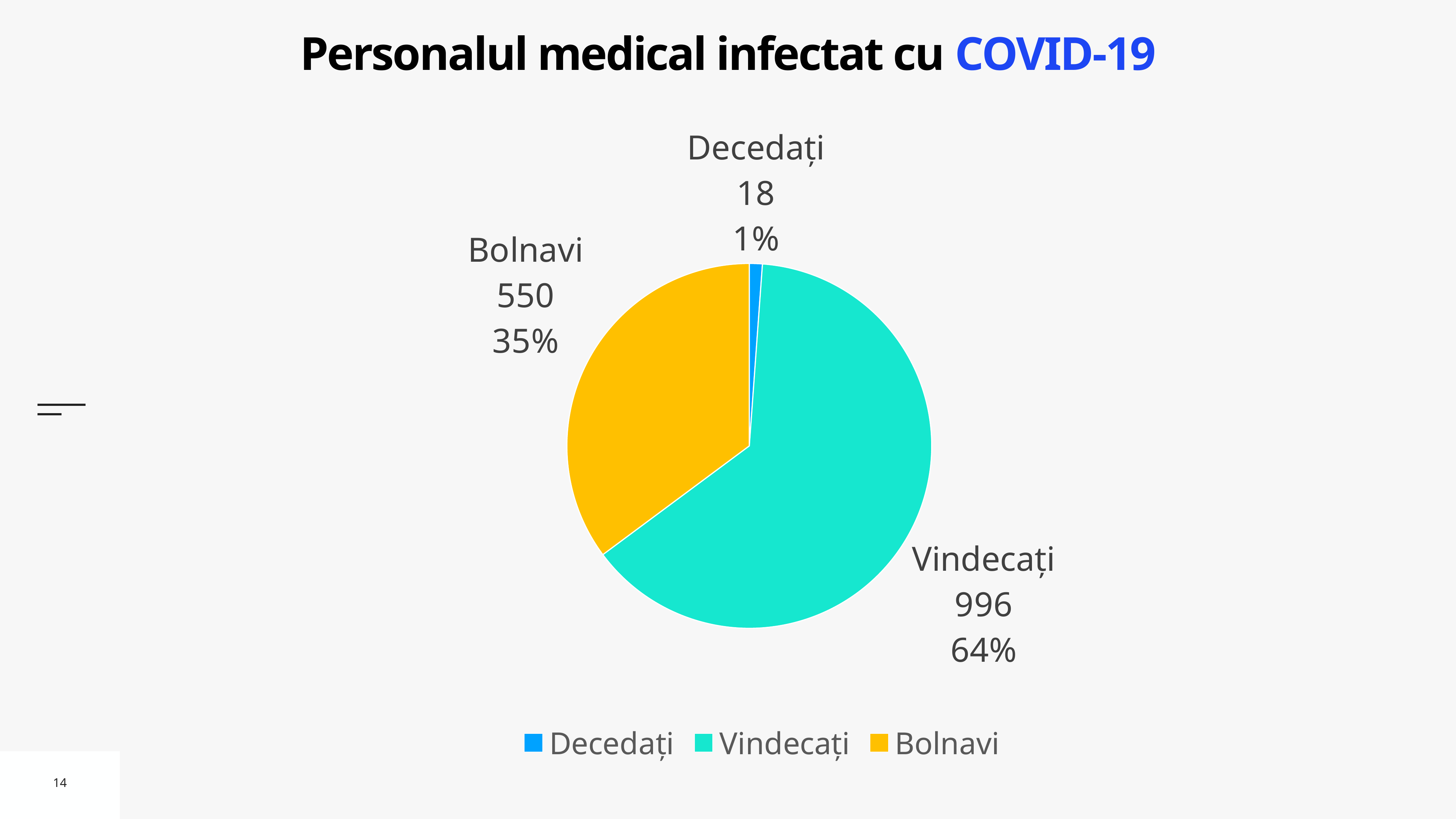
Which category has the smallest slice? Decedați What share of the pie does Bolnavi represent? 35% How many categories does the pie chart have? 3 What is the title of the slide? Personalul medical infectat cu COVID-19 Which is larger, the value for Bolnavi or the value for Decedați? Bolnavi Which category has the largest slice? Vindecați What is the difference between the values for Vindecați and Bolnavi? 446 What is the value for Vindecați? 996 What is the value for Bolnavi? 550 What share of the pie does Vindecați represent? 64% What kind of chart is shown on the slide? pie chart What is the value for Decedați? 18